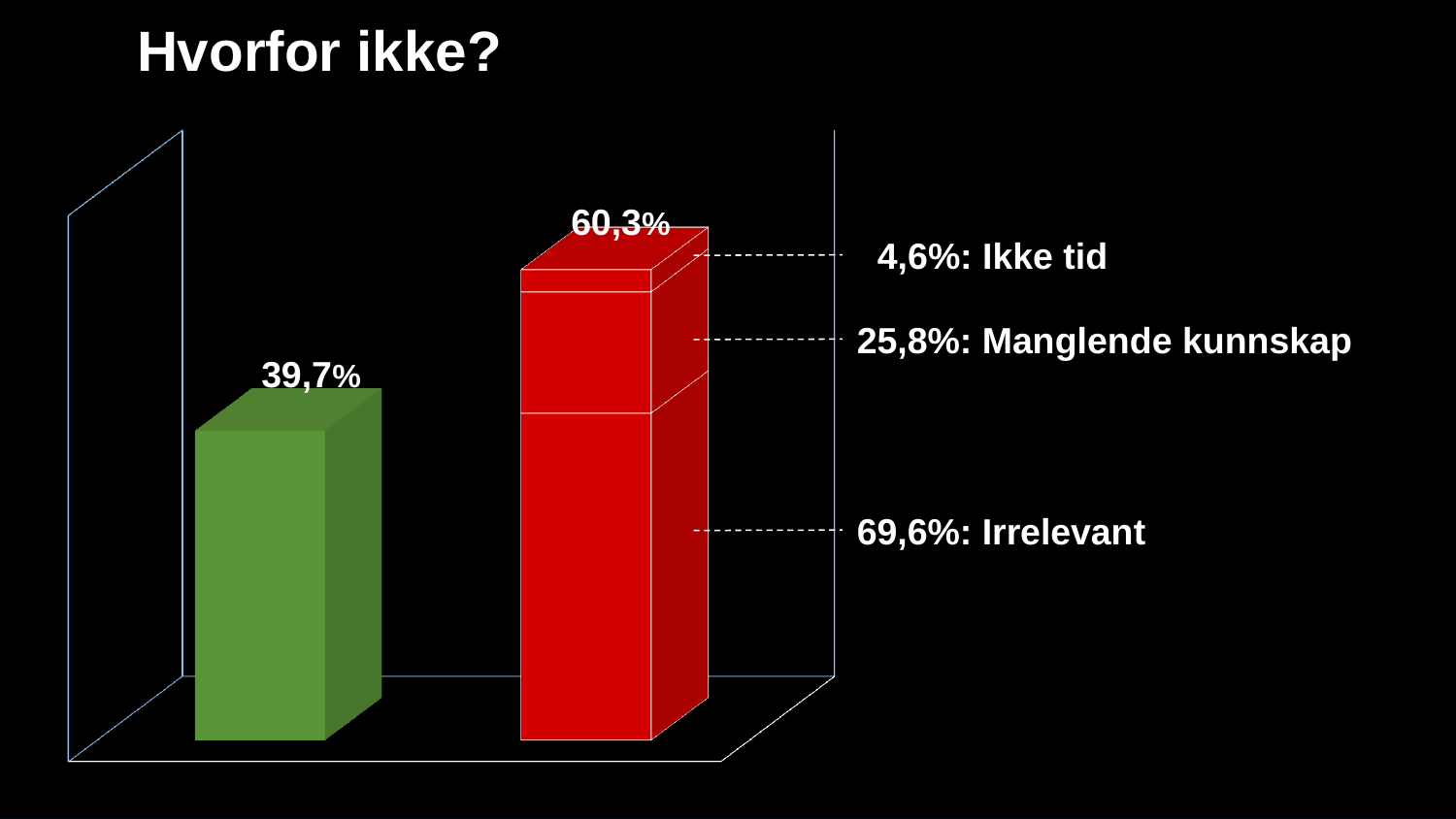
Which bar is taller, the green bar or the red bar? the red bar What percentage is labelled 'Ikke tid' next to the red bar? 4,6% What kind of chart is shown on the slide? bar chart What value is printed above the green bar? 39,7% What is the difference between the red bar's value (60,3%) and the green bar's value (39,7%)? 20,6% Which of the three labelled segments of the red bar has the smallest percentage? Ikke tid What percentage is labelled 'Irrelevant' next to the red bar? 69,6% Which of the three labelled segments of the red bar has the largest percentage? Irrelevant What is the title of the slide? Hvorfor ikke? What percentage is labelled 'Manglende kunnskap' next to the red bar? 25,8% What value is printed above the red bar? 60,3% How many bars are shown in the chart? 2